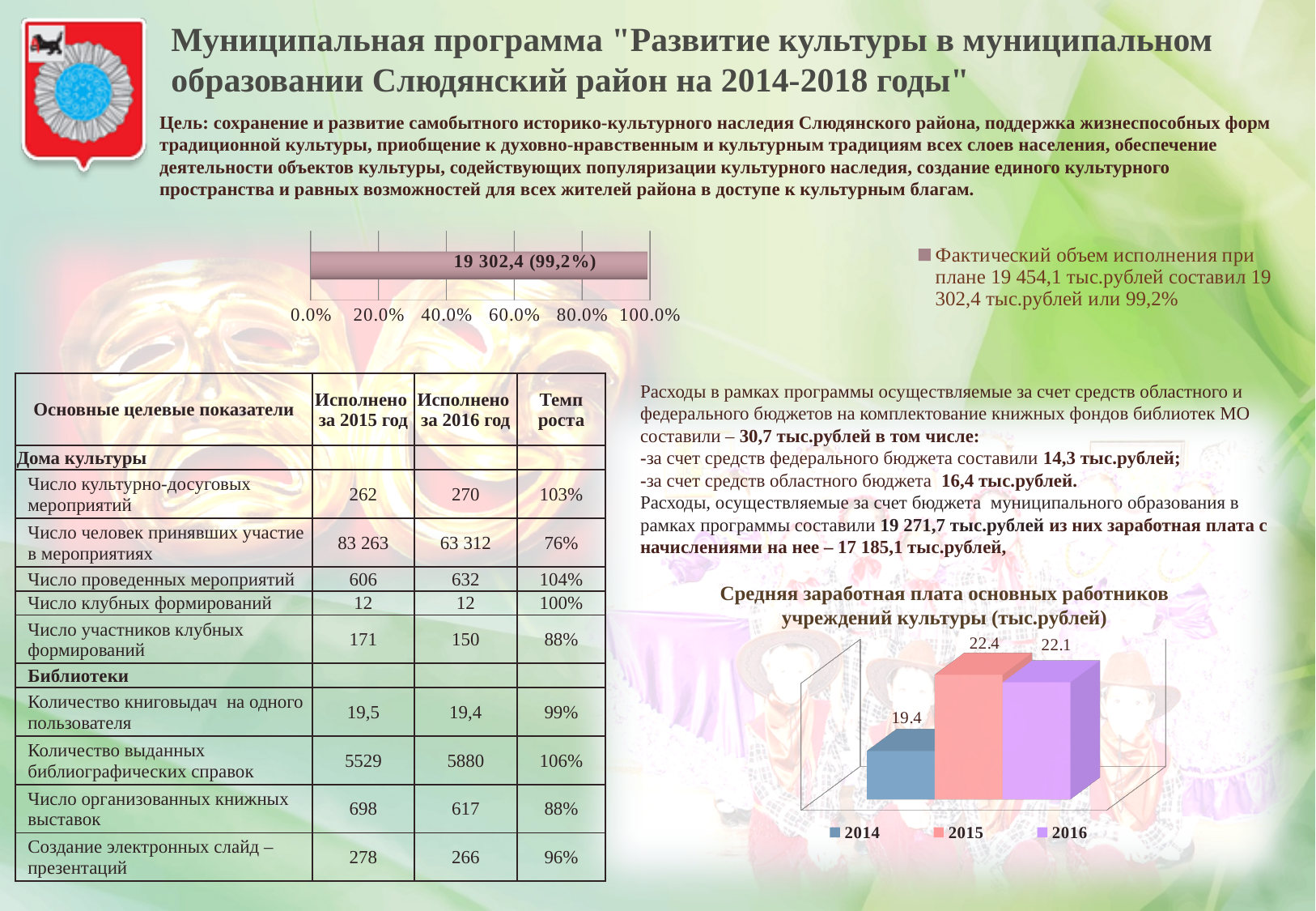
In the bottom-right chart on average salary, what is the difference between the 2015 and 2014 values? 3.0 In the bottom-right chart on average salary of cultural institution workers, what is the value for 2015? 22.4 In the bottom-right chart on average salary, which year has the highest value? 2015 In the bottom-right chart titled "Средняя заработная плата основных работников учреждений культуры (тыс.рублей)", what is the value for 2014? 19.4 In the top chart on budget execution, what is the data label printed on the bar? 19 302,4 (99,2%) What kind of chart is the bottom-right chart on average salary of cultural institution workers? bar chart In the top chart on budget execution, is the bar's value greater or less than 80.0%? greater In the bottom-right chart on average salary of cultural institution workers, what is the value for 2016? 22.1 In the bottom-right chart on average salary, which year has the lowest value? 2014 In the bottom-right chart on average salary, what is the difference between the 2015 and 2016 values? 0.3 In the bottom-right chart on average salary, which is larger: the value for 2016 or the value for 2014? 2016 How many series does the legend of the bottom-right chart on average salary list? 3